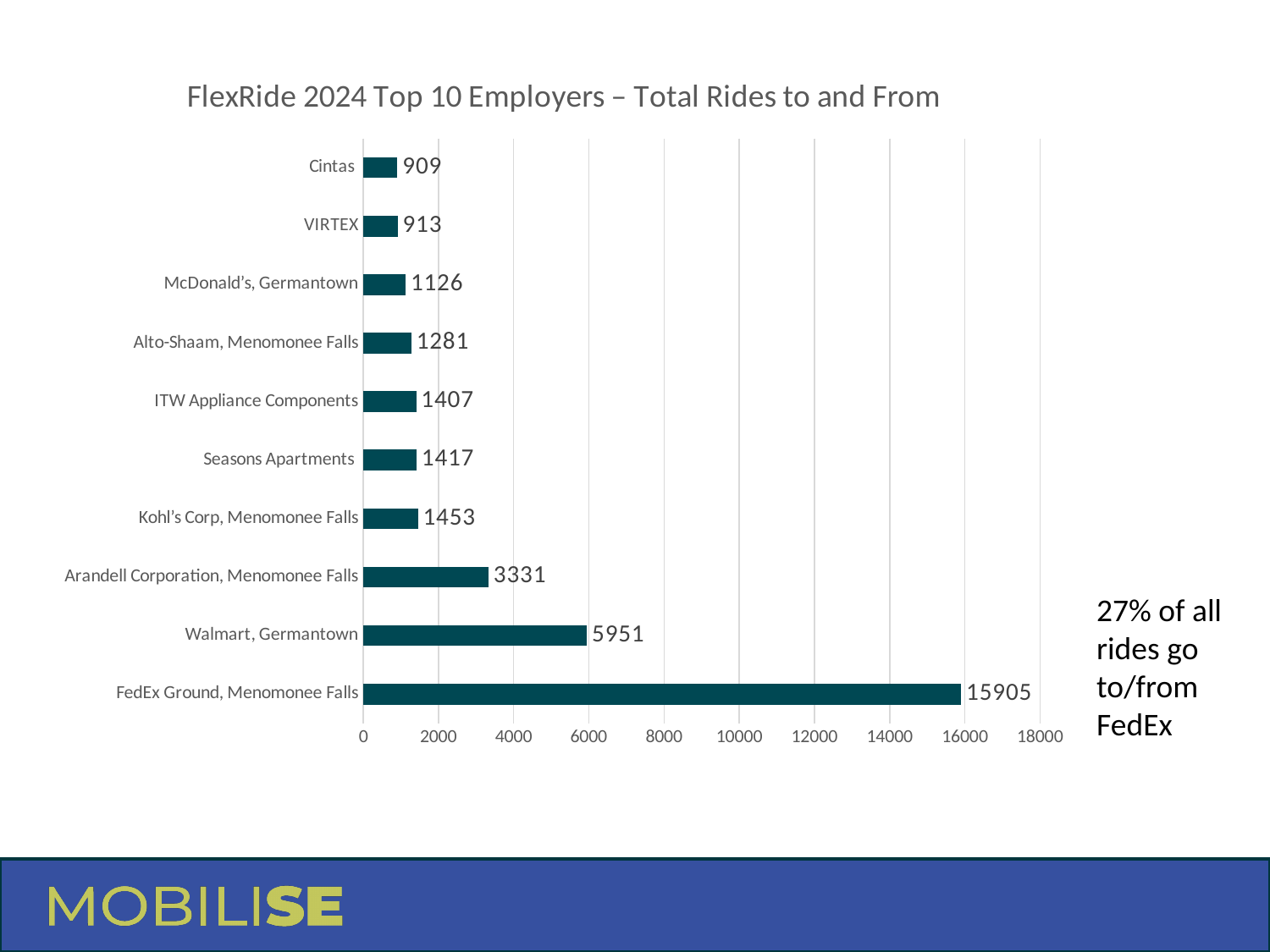
What is the total number of rides to and from FedEx Ground, Menomonee Falls? 15905 Is the value for Arandell Corporation, Menomonee Falls greater or less than 4000? less Which employer has the highest total rides? FedEx Ground, Menomonee Falls What is the value for Arandell Corporation, Menomonee Falls? 3331 What kind of chart is shown on the slide? bar chart How many rides are shown for Walmart, Germantown? 5951 What is the difference in rides between FedEx Ground, Menomonee Falls and Walmart, Germantown? 9954 How many employers are shown in the chart? 10 What is the value for McDonald's, Germantown? 1126 Which employer has the lowest total rides? Cintas Which has more rides, Kohl's Corp, Menomonee Falls or Seasons Apartments? Kohl's Corp, Menomonee Falls What is the title of the chart? FlexRide 2024 Top 10 Employers – Total Rides to and From